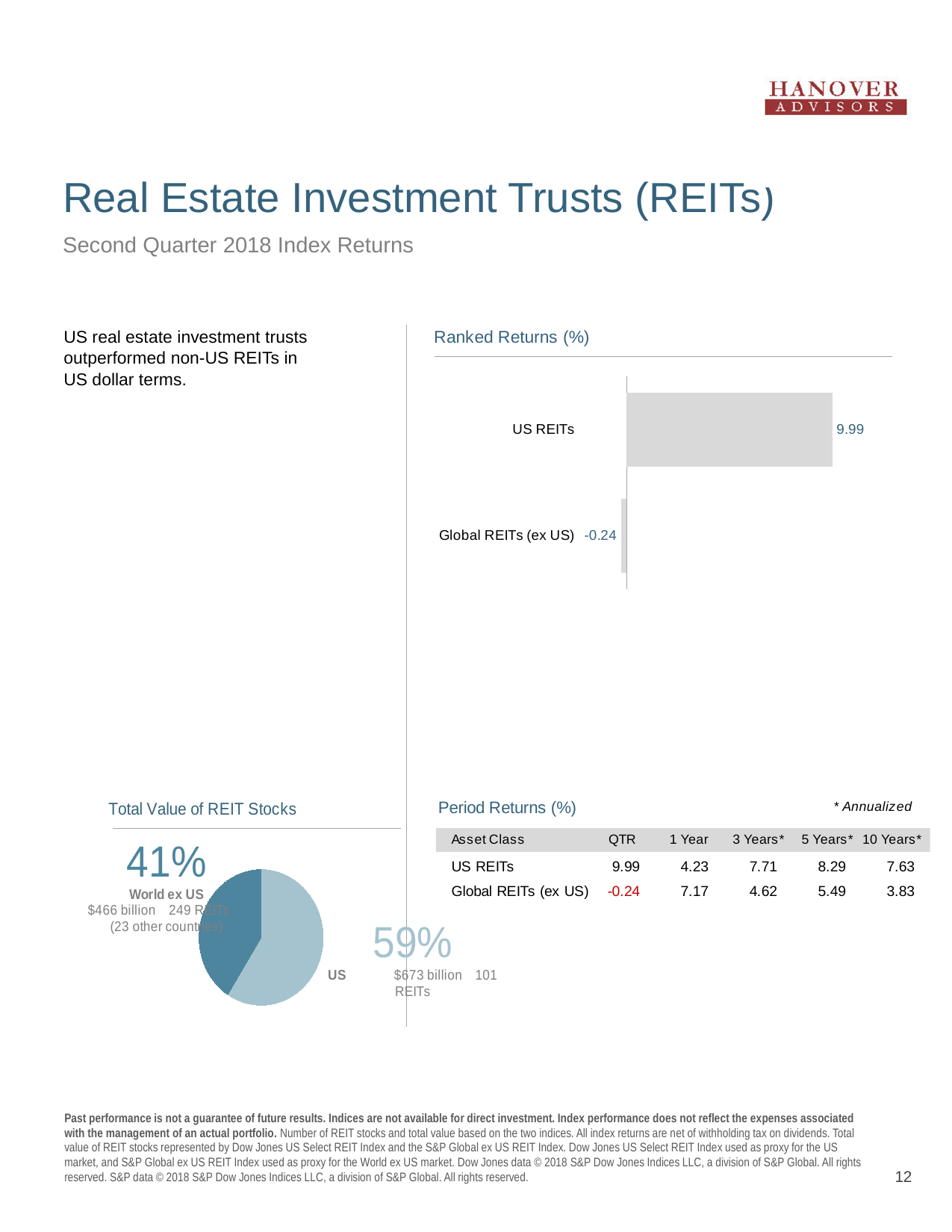
In the Total Value of REIT Stocks chart, which slice is larger, US or World ex US? US In the Ranked Returns (%) chart, is the value for Global REITs (ex US) positive or negative? Negative In the Ranked Returns (%) chart, what is the difference between the US REITs value and the Global REITs (ex US) value? 10.23 What kind of chart is the Total Value of REIT Stocks chart? Pie chart In the Ranked Returns (%) chart, how many categories are plotted? 2 In the Ranked Returns (%) chart, which category has the lowest value? Global REITs (ex US) In the Ranked Returns (%) chart, what is the value for US REITs? 9.99 What kind of chart is the Ranked Returns (%) chart? Bar chart In the Ranked Returns (%) chart, what is the value for Global REITs (ex US)? -0.24 In the Ranked Returns (%) chart, which category has the highest value? US REITs In the Total Value of REIT Stocks chart, what share does World ex US represent? 41% In the Total Value of REIT Stocks chart, what share does US represent? 59%